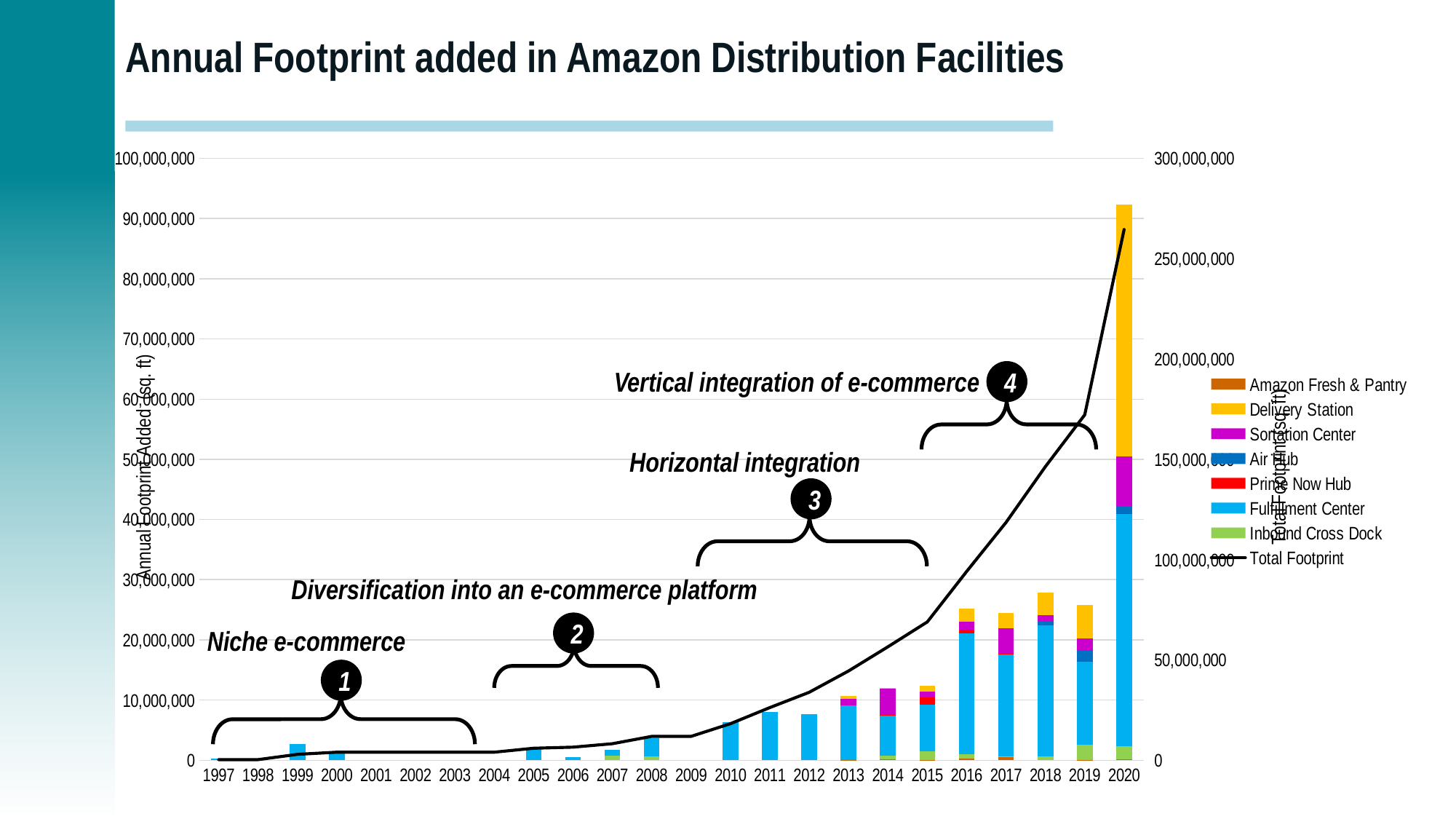
How many years are shown along the x axis? 24 Is the annual footprint added in 2020 greater or less than 80,000,000? greater What is the title of the chart? Annual Footprint added in Amazon Distribution Facilities Which year has the taller bar, 2017 or 2018? 2018 Is the annual footprint added in 2018 greater or less than 20,000,000? greater Is the Total Footprint line value in 2020 greater or less than 250,000,000 on the right axis? greater Which year has the taller bar, 2010 or 2011? 2011 How many series does the legend list? 8 Which year has the tallest bar for annual footprint added? 2020 Does the Total Footprint line rise or fall from 1997 to 2020? rise What kind of chart is shown on the slide? A stacked bar chart with a line